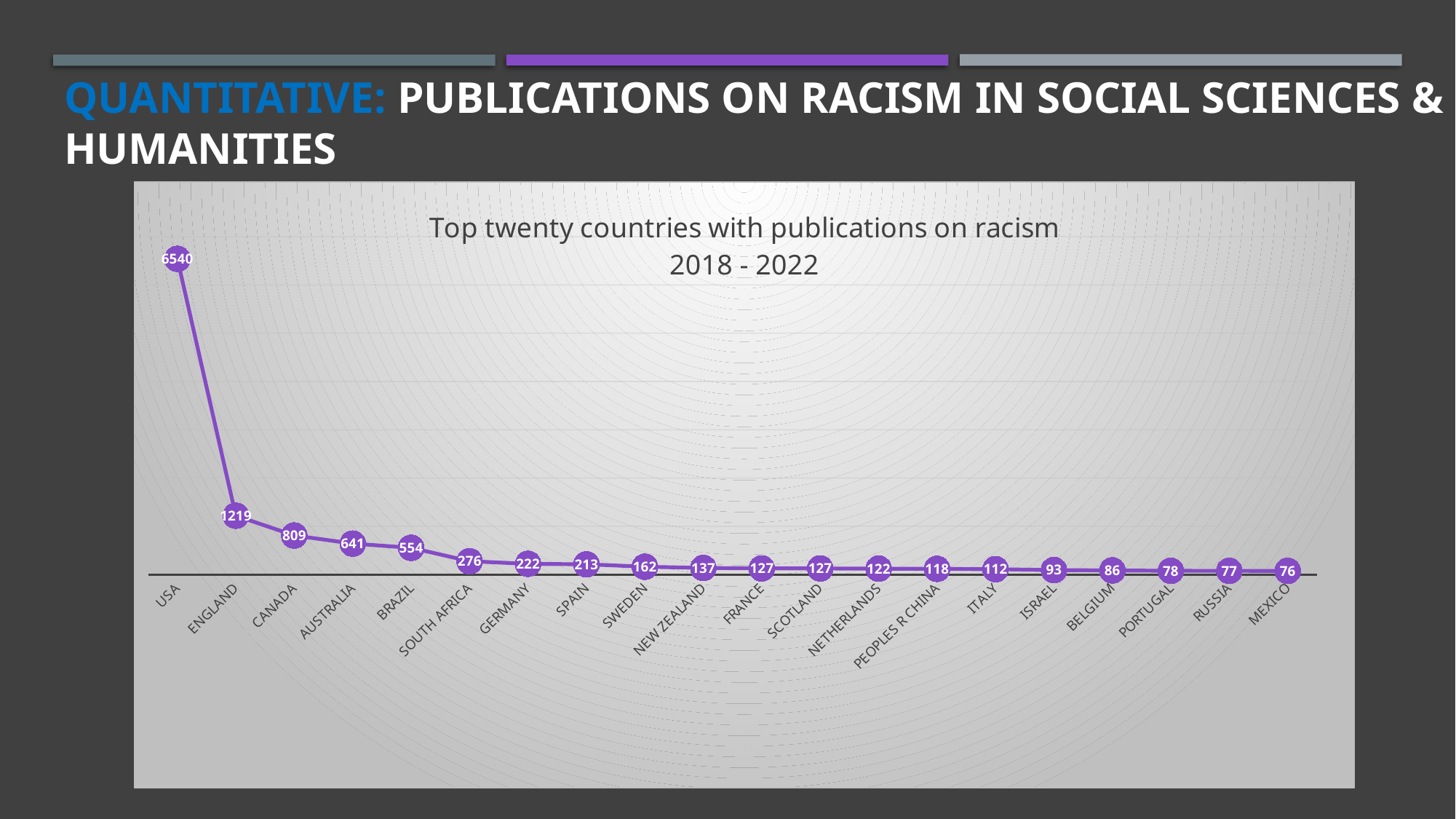
Which country has the highest value? USA What is the difference between the values for USA and England? 5321 What is the value for South Africa? 276 Which has a larger value, Germany or Sweden? Germany What kind of chart is shown? Line chart Which country has the lowest value? Mexico What is the difference between the values for Australia and Brazil? 87 What is the value for Canada? 809 What is the value for Peoples R China? 118 Do the values rise or fall from left to right along the x axis? Fall How many countries are plotted on the chart? 20 What is the value for USA? 6540